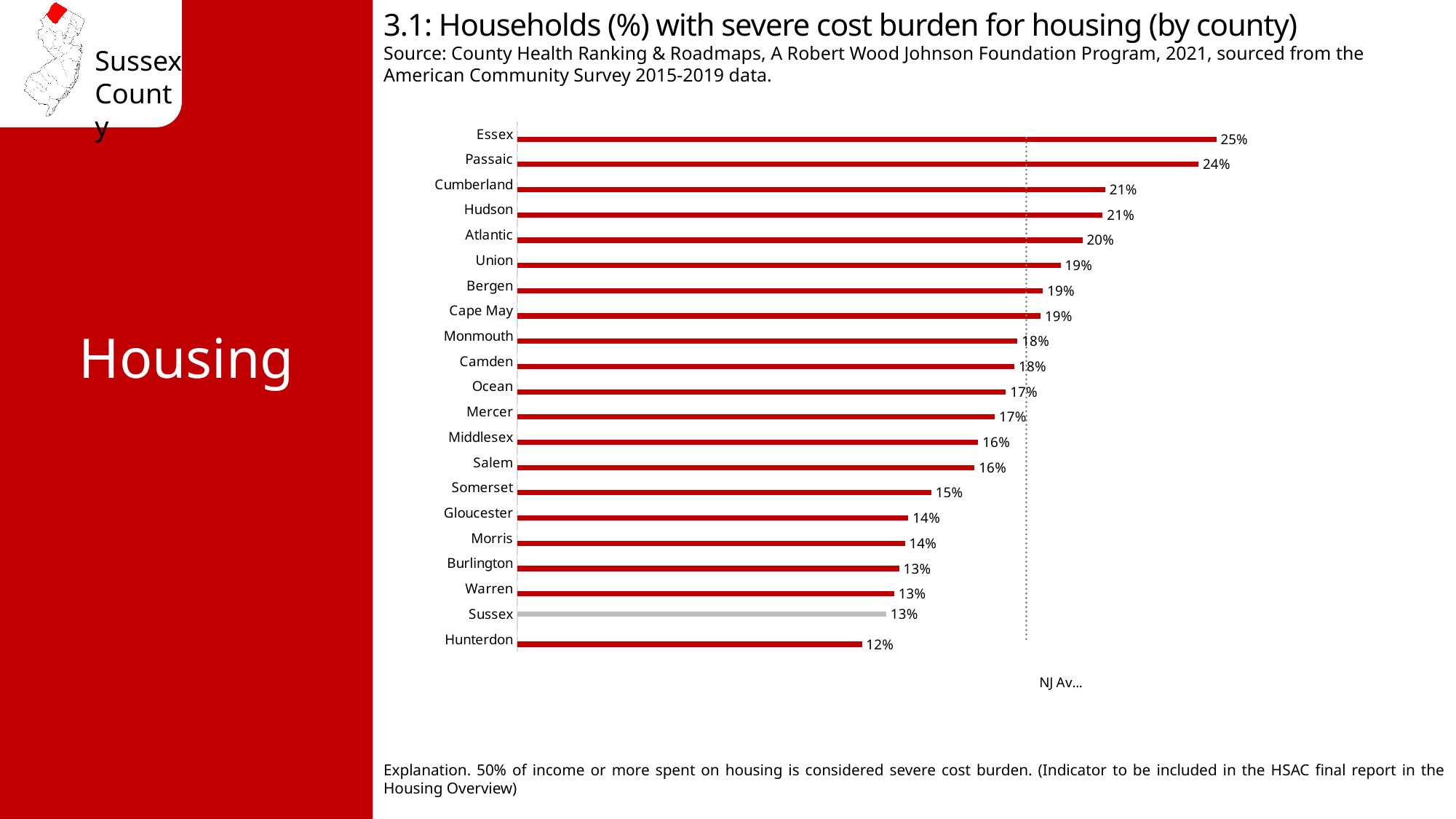
What is the value for Atlantic? 20% Which has a larger value, Cumberland or Middlesex? Cumberland How many counties are shown in the chart? 21 What kind of chart is shown on the slide? Bar chart Which county has the highest value? Essex Which county's bar is shown in gray instead of red? Sussex Which county has the lowest value? Hunterdon What is the difference between the values for Passaic and Sussex? 11% What is the value for Sussex? 13% What is the difference between the values for Essex and Hunterdon? 13% What is the value for Somerset? 15% What is the value for Essex? 25%